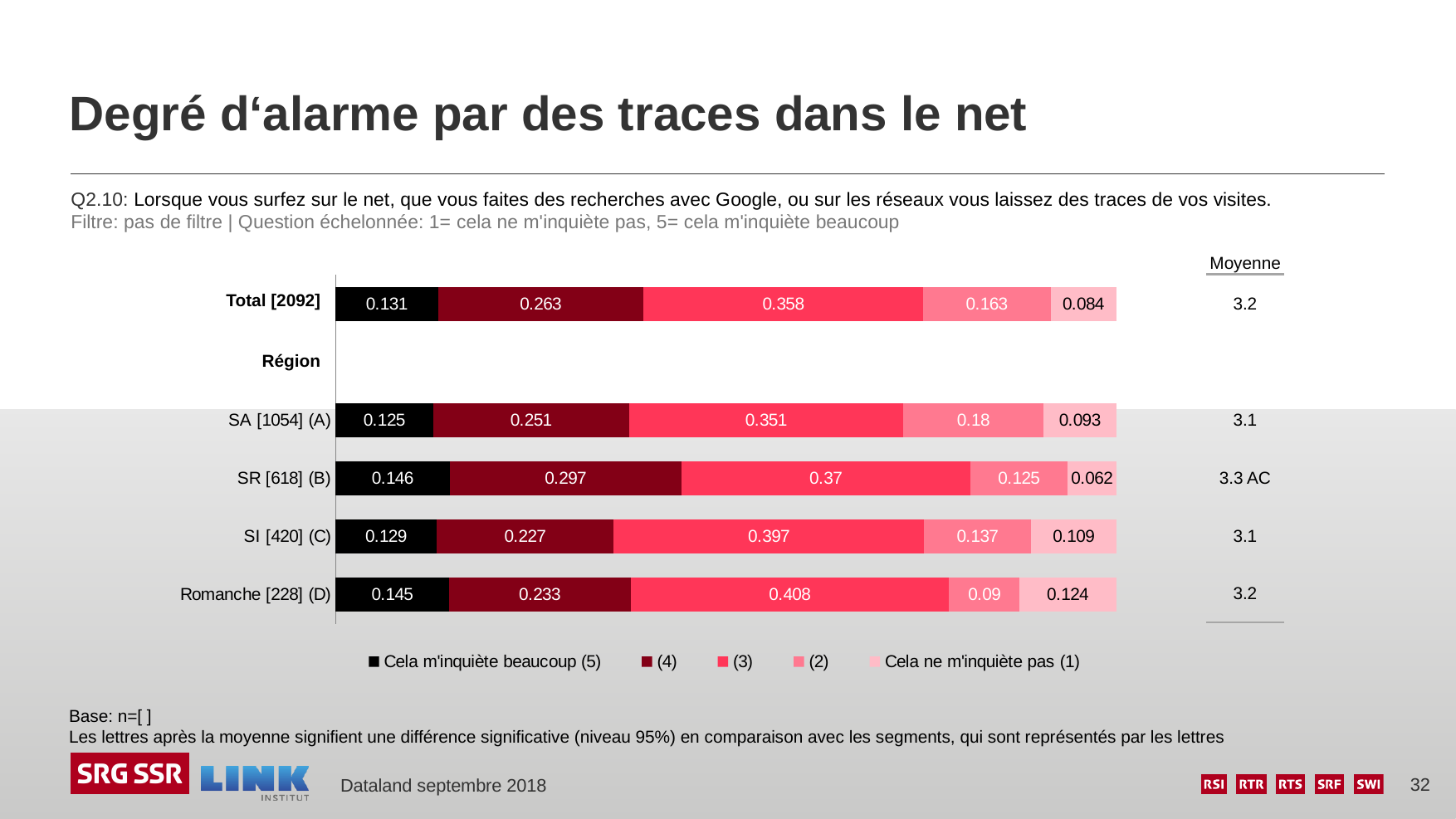
What kind of chart is shown on the slide? Stacked bar chart What is the value of the "Cela ne m'inquiète pas (1)" segment for Romanche [228] (D)? 0.124 What is the Moyenne value shown for SR [618] (B)? 3.3 AC How many series does the legend list? 5 Which category has the highest value for the "(3)" segment? Romanche [228] (D) Which has a larger "(2)" value: SA [1054] (A) or SI [420] (C)? SA [1054] (A) What is the value of the "Cela m'inquiète beaucoup (5)" segment for SR [618] (B)? 0.146 What is the value of the "(3)" segment for SI [420] (C)? 0.397 What is the difference between the "(4)" values for SR [618] (B) and SI [420] (C)? 0.07 How many bars are plotted in the chart? 5 Which category has the lowest value for the "(2)" segment? Romanche [228] (D) What is the value of the "(3)" segment for Total [2092]? 0.358